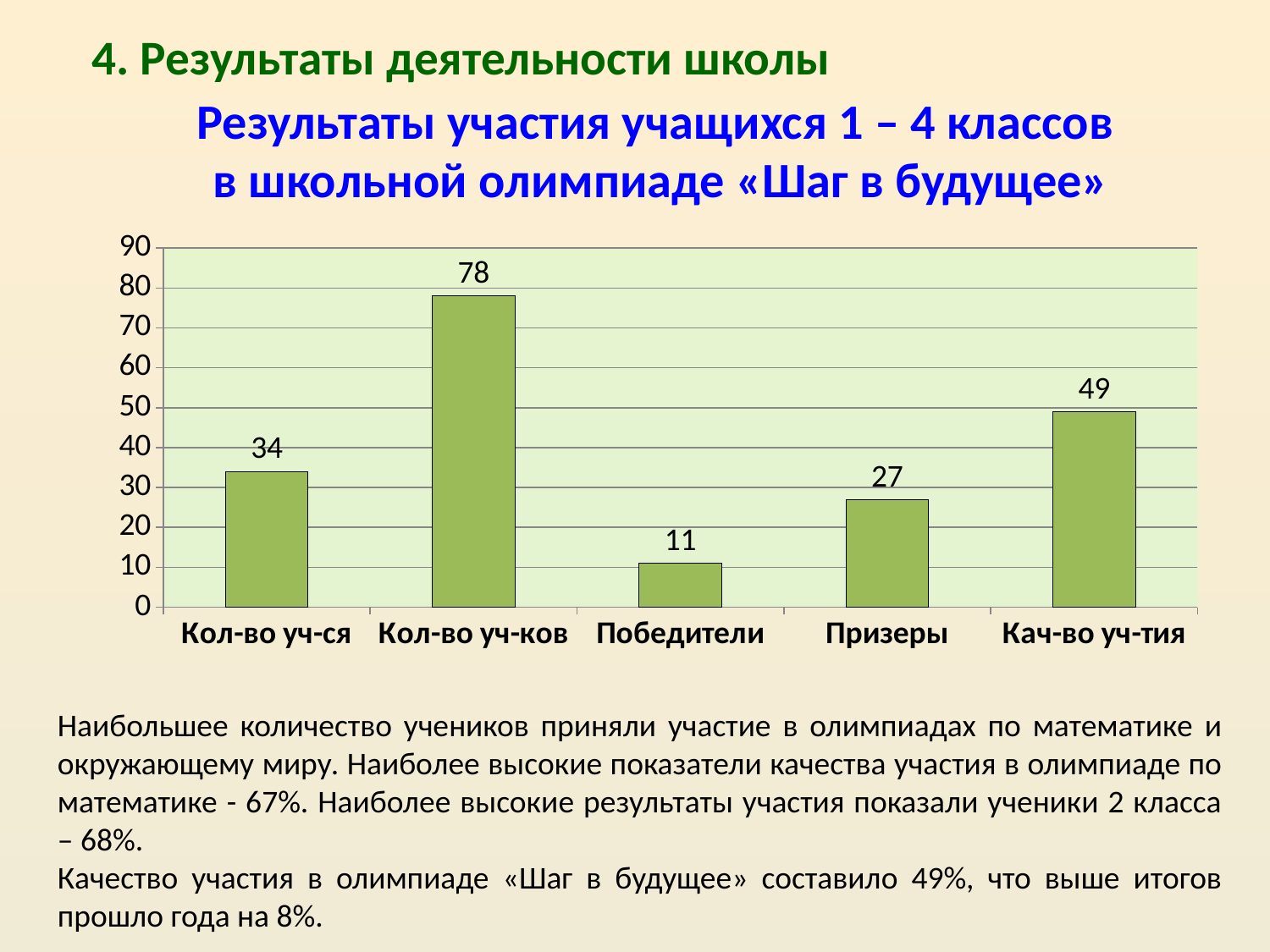
What is the value for Кач-во уч-тия? 49 What is the value for Победители? 11 How many categories are shown on the x axis? 5 What colour are the bars in the chart? green What is the difference between the values for Призеры and Победители? 16 What is the difference between the values for Кол-во уч-ков and Кол-во уч-ся? 44 What is the value for Призеры? 27 What is the value for Кол-во уч-ков? 78 Which category has the lowest value? Победители What kind of chart is shown on the slide? bar chart Which is larger, the value for Кач-во уч-тия or the value for Кол-во уч-ся? Кач-во уч-тия Which category has the highest value? Кол-во уч-ков